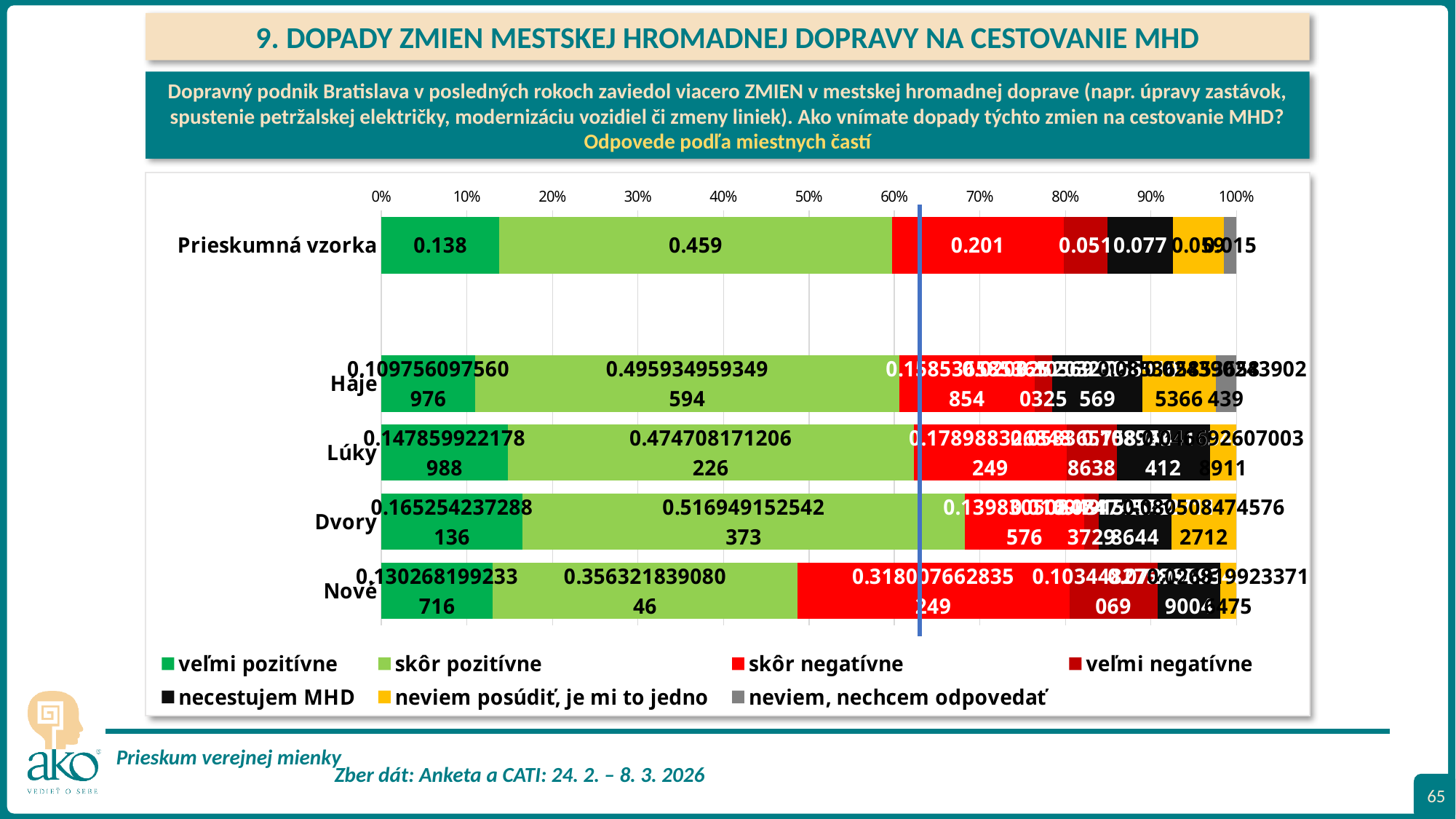
Which is larger, the 'veľmi pozitívne' value for Dvory or for Nové? Dvory How many series does the legend list? 7 Which colour represents 'necestujem MHD' in the legend? black Which category has the largest 'skôr pozitívne' segment? Dvory Which category has the largest 'skôr negatívne' segment? Nové What kind of chart is shown on the slide? bar chart What is the value of 'veľmi pozitívne' for Prieskumná vzorka? 0.138 What is the value of 'skôr negatívne' for Prieskumná vzorka? 0.201 What is the value of 'necestujem MHD' for Prieskumná vzorka? 0.077 How many categories (rows) are plotted in the chart? 5 What is the value of 'skôr pozitívne' for Prieskumná vzorka? 0.459 For Prieskumná vzorka, what is the difference between the 'skôr pozitívne' and 'veľmi pozitívne' values? 0.321